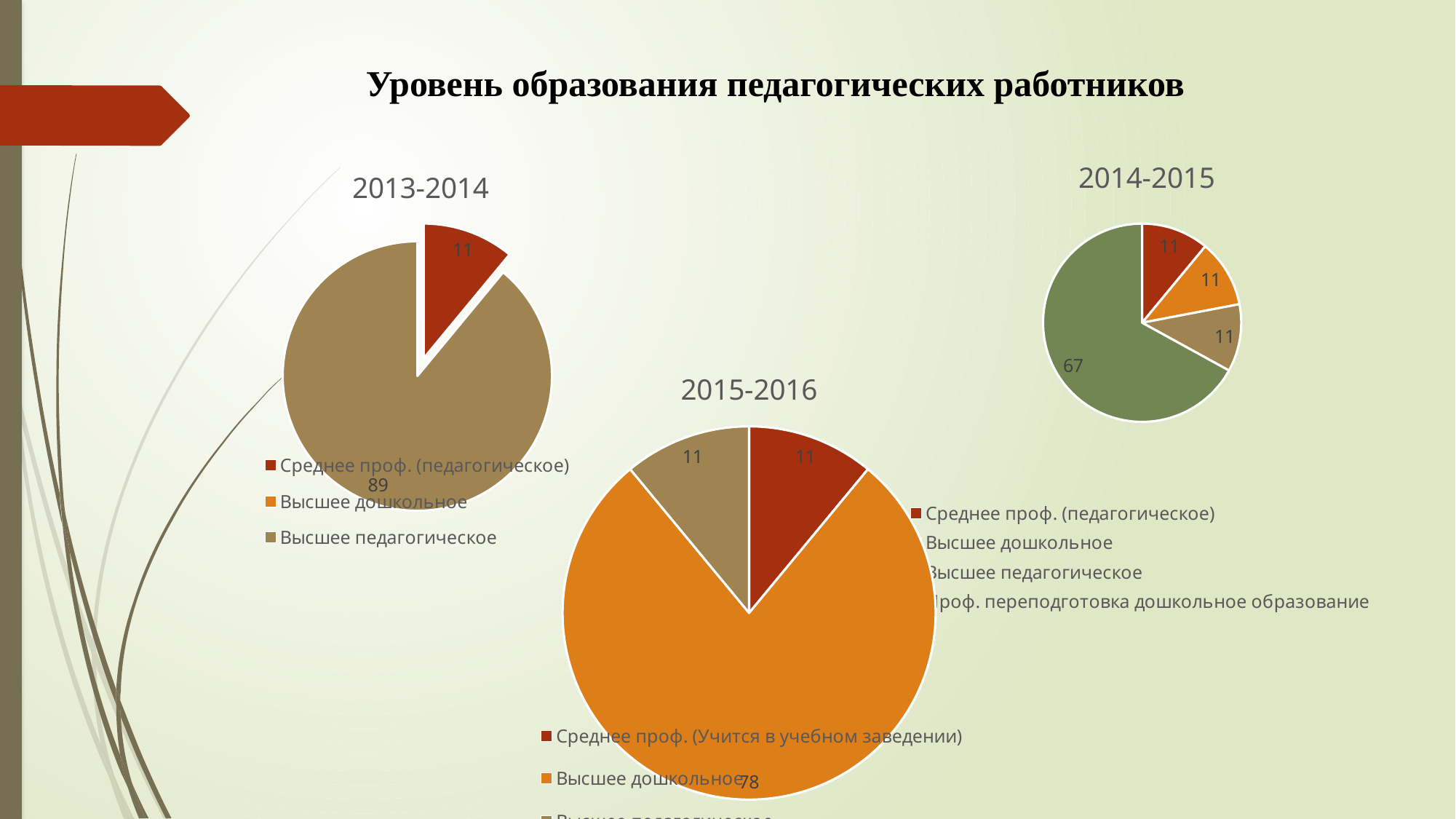
In the 2013-2014 chart, what is the difference between the two slices shown? 78 In the 2014-2015 chart, what is the value of the largest slice? 67 In the 2015-2016 chart, which category has the largest slice? Высшее дошкольное In the 2015-2016 chart, what is the difference between the Высшее дошкольное slice and the Высшее педагогическое slice? 67 In the 2013-2014 chart, what is the value for Высшее педагогическое? 89 In the 2013-2014 chart, what is the value for Среднее проф. (педагогическое)? 11 In the 2014-2015 chart, what is the value for Высшее дошкольное? 11 In the 2015-2016 chart, what is the value for Высшее дошкольное? 78 What type of chart is used for 2013-2014? Pie chart In the 2013-2014 chart, which is larger: Среднее проф. (педагогическое) or Высшее педагогическое? Высшее педагогическое In the 2014-2015 chart, how many slices does the pie have? 4 How many entries does the legend of the 2014-2015 chart list? 4